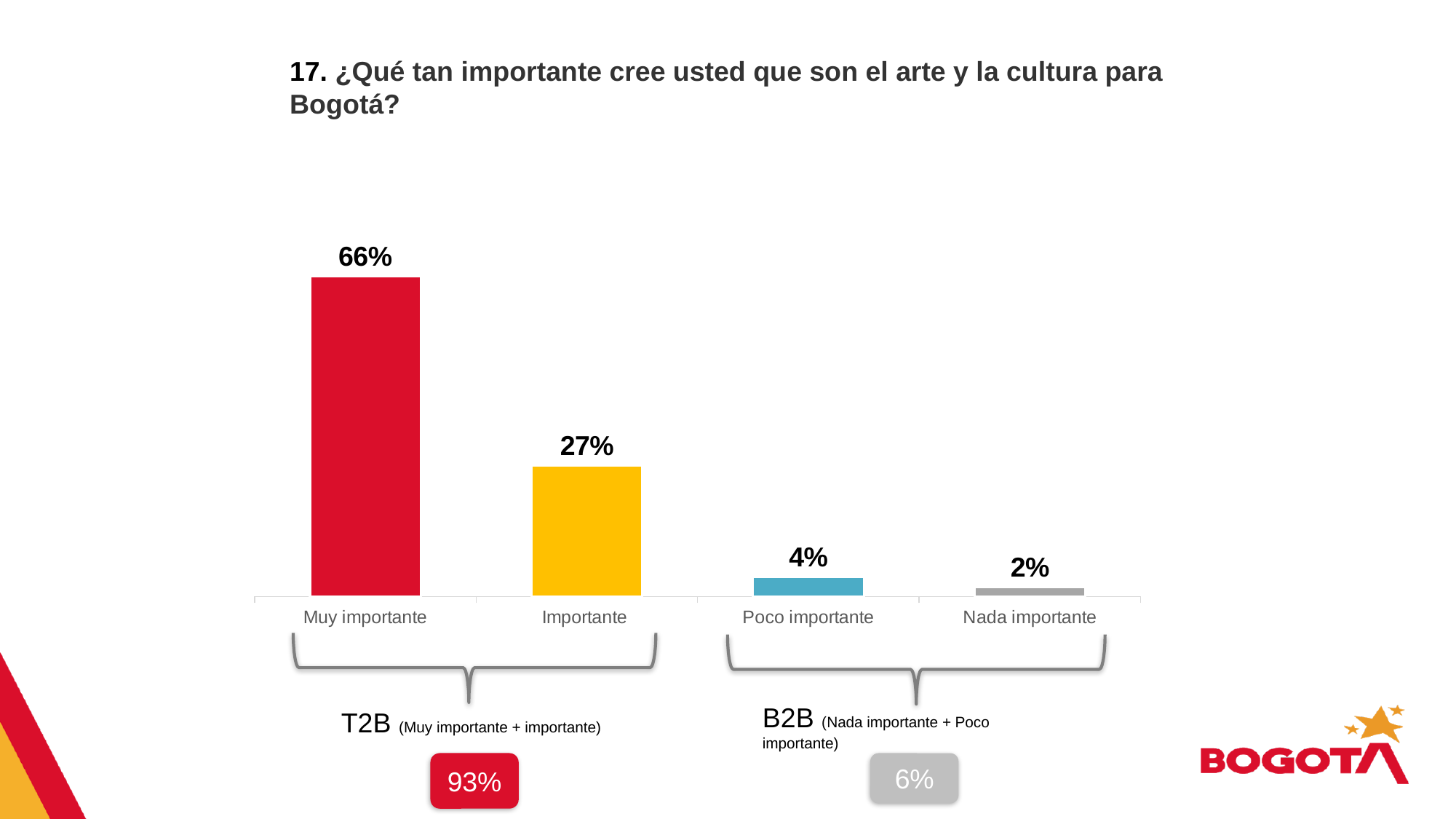
What is the value for Nada importante? 2% Which category has the lowest value? Nada importante Which is larger, the value for Poco importante or the value for Nada importante? Poco importante What kind of chart is shown on the slide? Bar chart Which category has the highest value? Muy importante How many categories are shown in the chart? 4 What is the value for Importante? 27% Do the values rise or fall from left to right along the x axis? Fall What is the value for Muy importante? 66% What T2B (Muy importante + importante) value is shown below the chart? 93% What is the value for Poco importante? 4% What is the difference between the values for Muy importante and Importante? 39%